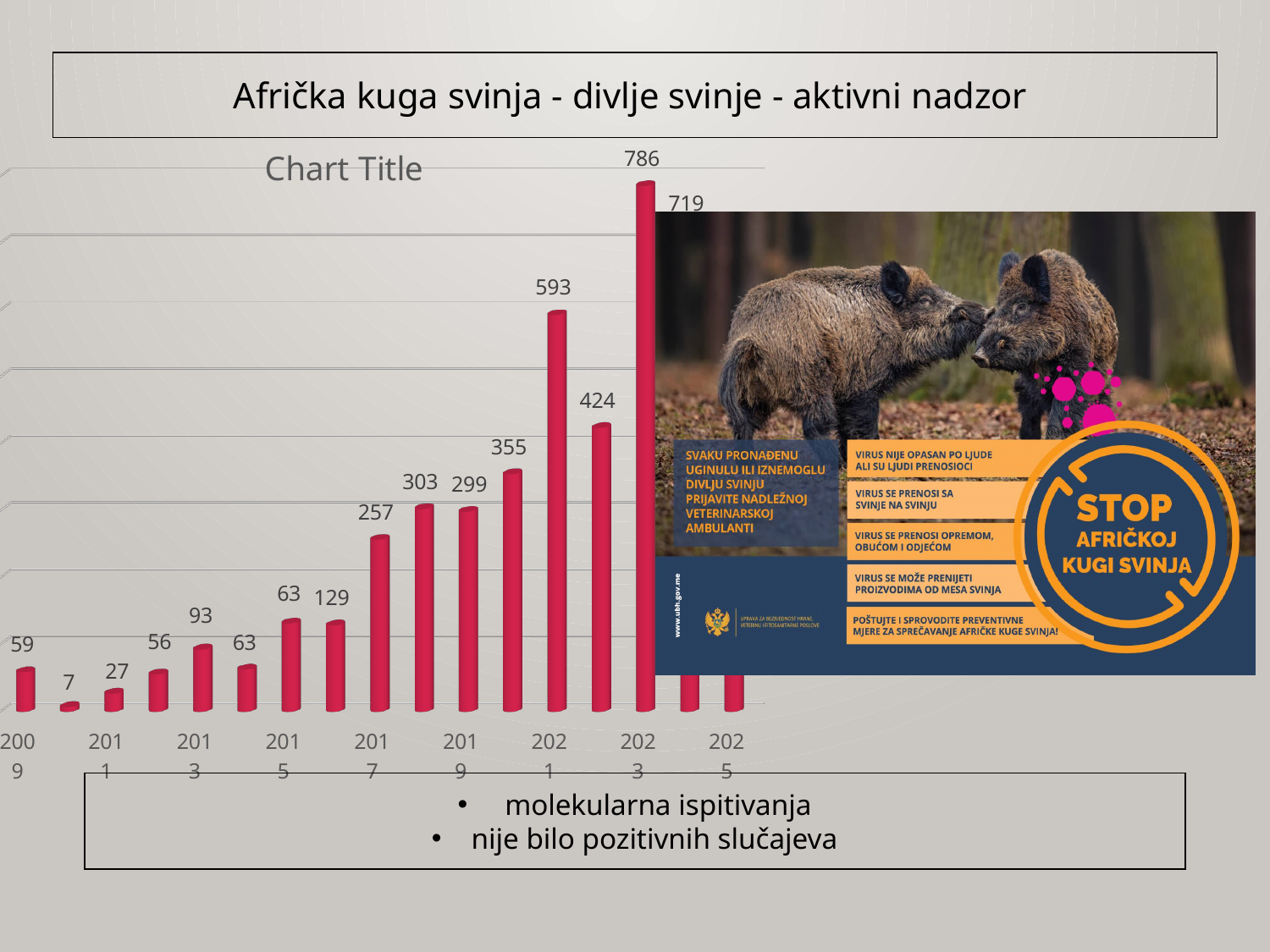
What is the value for 2021? 593 What is the value for 2017? 257 What is the difference between the values for 2023 and 2021? 193 What is the value for 2009? 59 What is the title shown above the chart? Chart Title Which year has the highest value? 2023 What kind of chart is shown on the slide? bar chart Do the values generally rise or fall from 2009 to 2023? rise What is the lowest value shown on the chart? 7 What is the value for 2023? 786 What is the value for 2013? 93